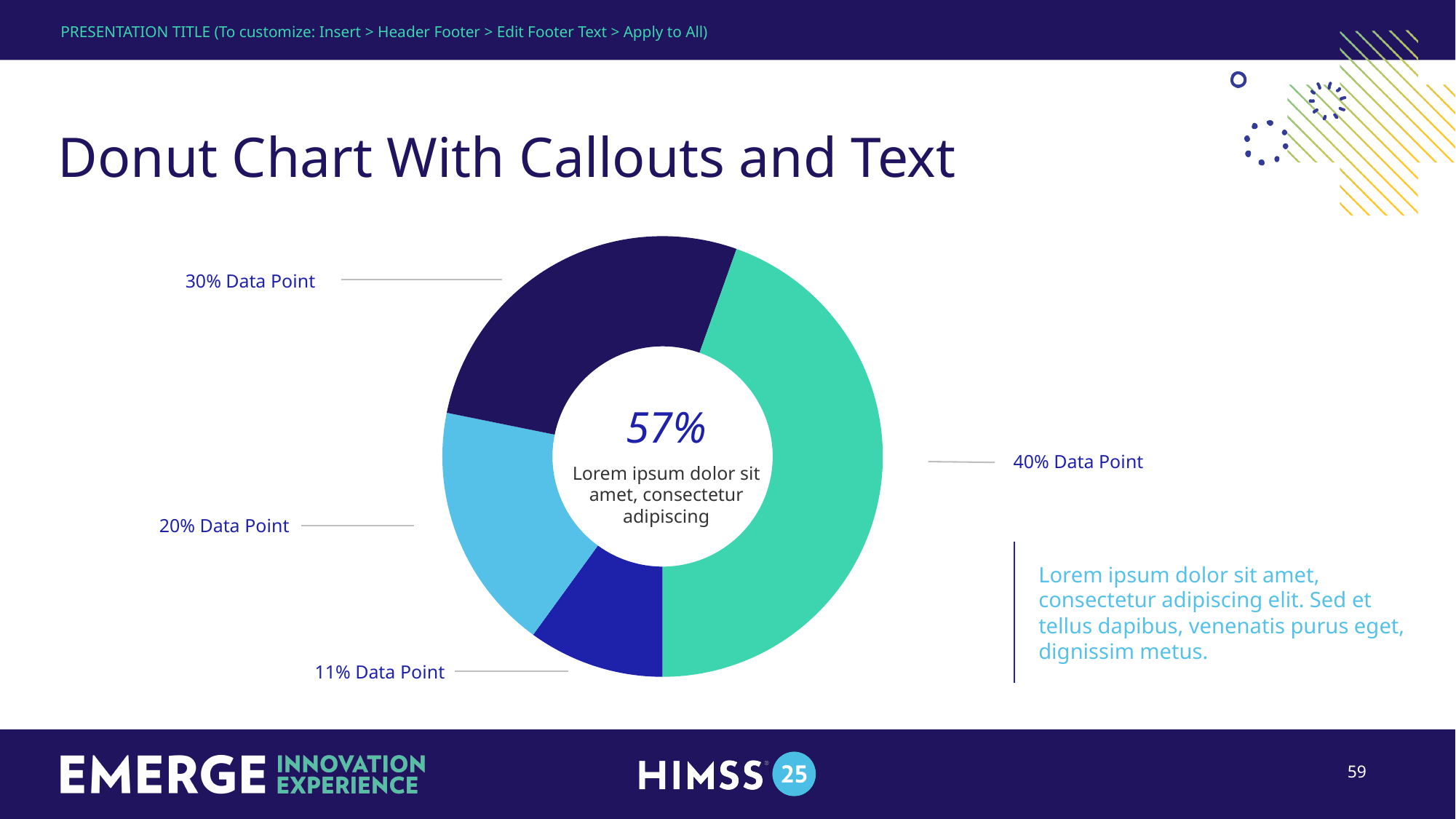
What is the combined share of the 30% Data Point and 20% Data Point slices? 50% What is the difference between the 30% Data Point slice and the 20% Data Point slice? 10% Which is larger, the 30% Data Point slice or the 20% Data Point slice? 30% Data Point What percentage is printed in the centre of the donut chart? 57% Which slice of the donut chart is the smallest? 11% Data Point Which slice of the donut chart is the largest? 40% Data Point What is the title of the slide containing the donut chart? Donut Chart With Callouts and Text How many slices does the donut chart have? 4 What colour is the 40% Data Point slice of the donut chart? Teal (green) What kind of chart is shown on the slide? Donut chart